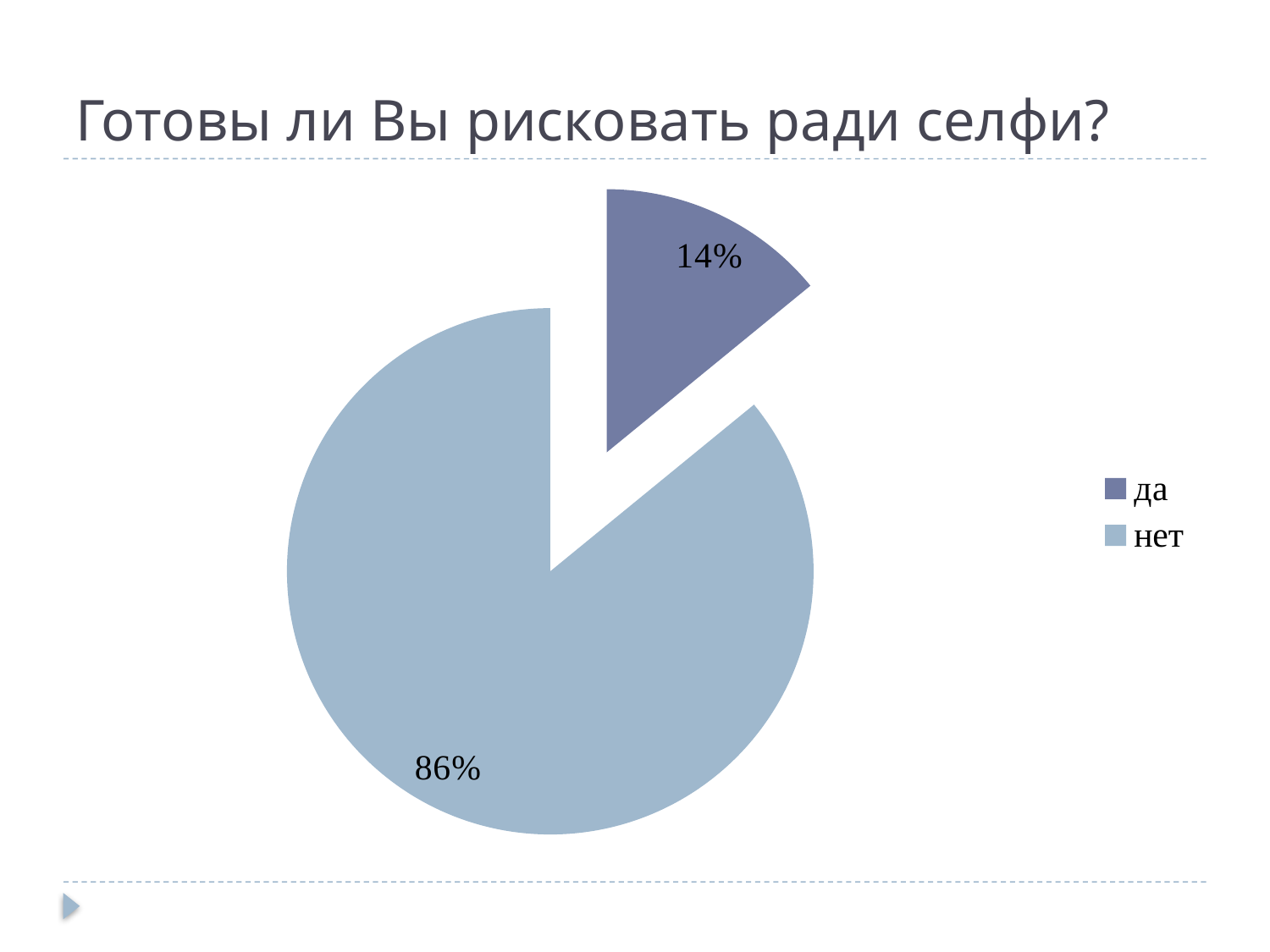
Which category has the smallest slice of the pie? да Which category has the largest slice of the pie? нет Is the value for "да" greater or less than 50%? less What share of the pie does the "да" slice represent? 14% What kind of chart is shown on the slide? pie chart Which category is shown in the darker blue colour? да Is the value for "нет" greater or less than 50%? greater What share of the pie does the "нет" slice represent? 86% What is the difference in percentage points between the "нет" and "да" slices? 72% How many categories are shown in the pie chart? 2 Which slice is larger, "да" or "нет"? нет What is the title of the slide? Готовы ли Вы рисковать ради селфи?